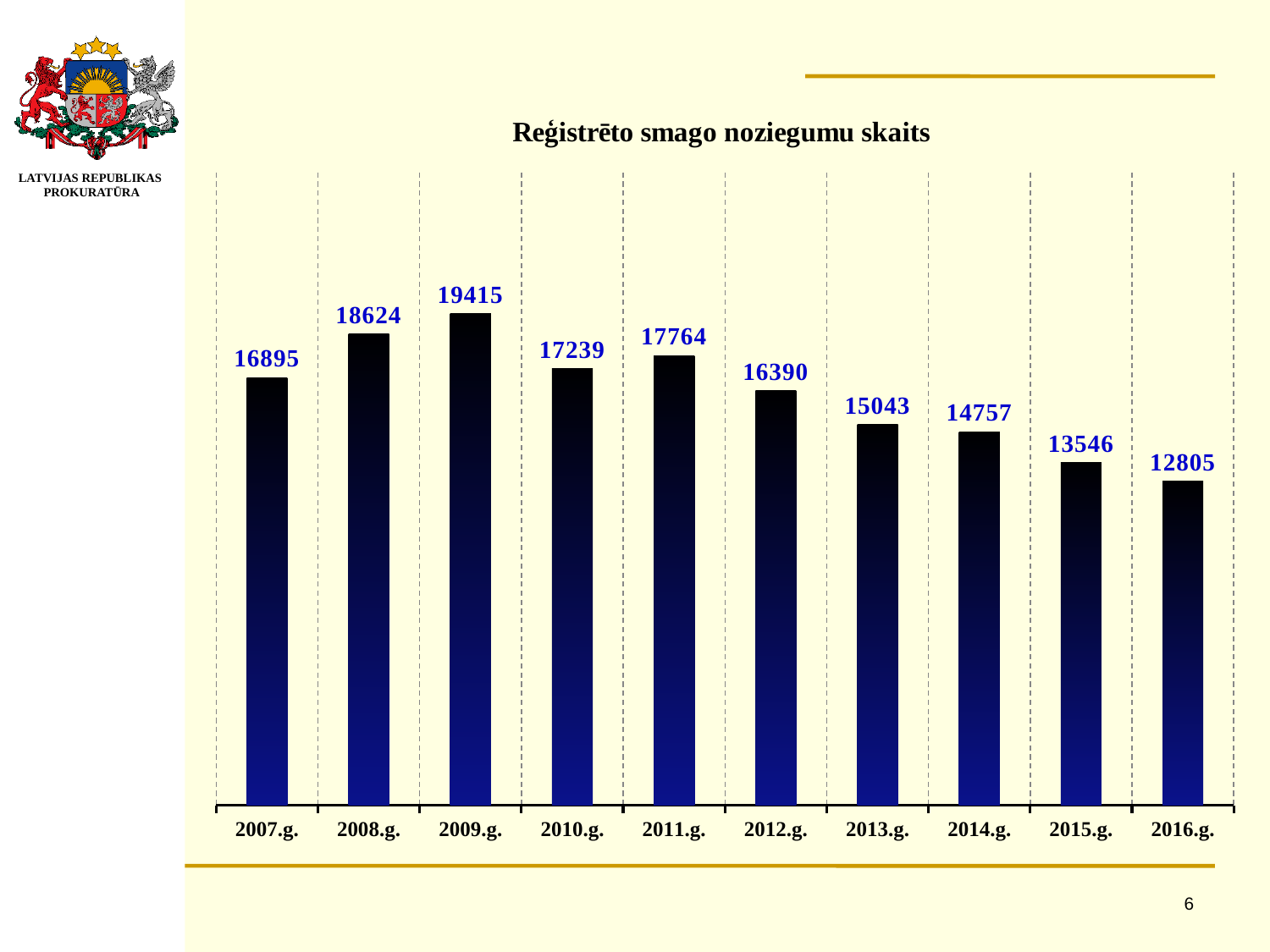
What is the value for 2016.g.? 12805 What is the difference between the values for 2009.g. and 2016.g.? 6610 Which year has the highest value? 2009.g. How many years are shown on the x axis? 10 What is the difference between the values for 2007.g. and 2008.g.? 1729 What kind of chart is this? bar chart Which is larger, the value for 2010.g. or the value for 2011.g.? 2011.g. What is the value for 2012.g.? 16390 Do the values rise or fall from 2011.g. to 2016.g.? fall What is the title of the chart? Reģistrēto smago noziegumu skaits What is the value for 2009.g.? 19415 Which year has the lowest value? 2016.g.